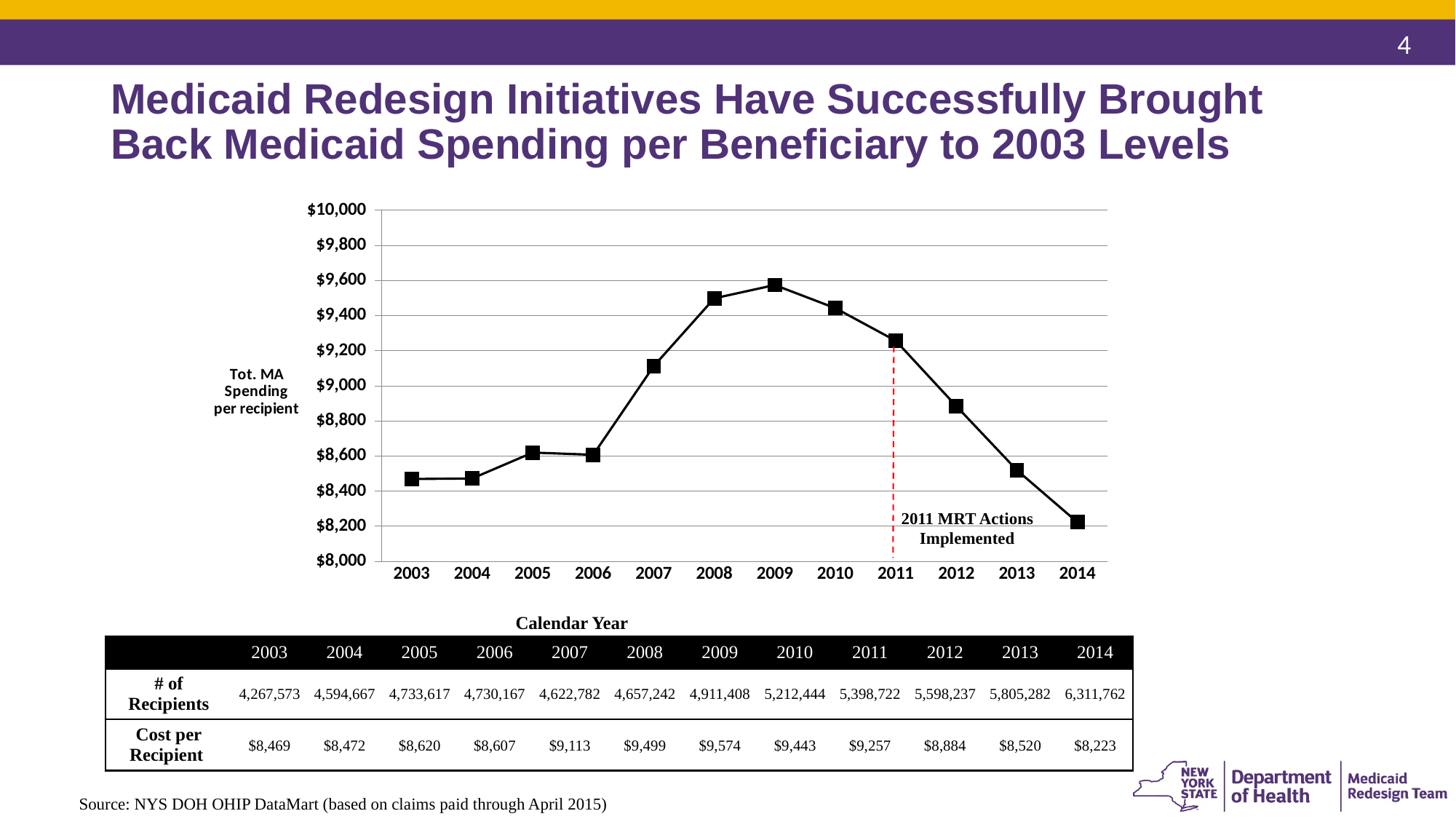
What event does the red dashed vertical line on the chart mark? 2011 MRT Actions Implemented In which year is Tot. MA Spending per recipient lowest? 2014 Is the Tot. MA Spending per recipient for 2007 greater or less than $9,000? greater What type of chart is shown on the slide? line chart How many years are plotted on the x axis of the chart? 12 What is the Cost per Recipient for 2003? $8,469 What is the difference in Cost per Recipient between 2009 and 2014? $1,351 Does Tot. MA Spending per recipient rise or fall from 2011 to 2014? fall Which year has a higher Tot. MA Spending per recipient, 2008 or 2012? 2008 In which year is Tot. MA Spending per recipient highest? 2009 What is the Cost per Recipient for 2009? $9,574 What is the Cost per Recipient for 2014? $8,223